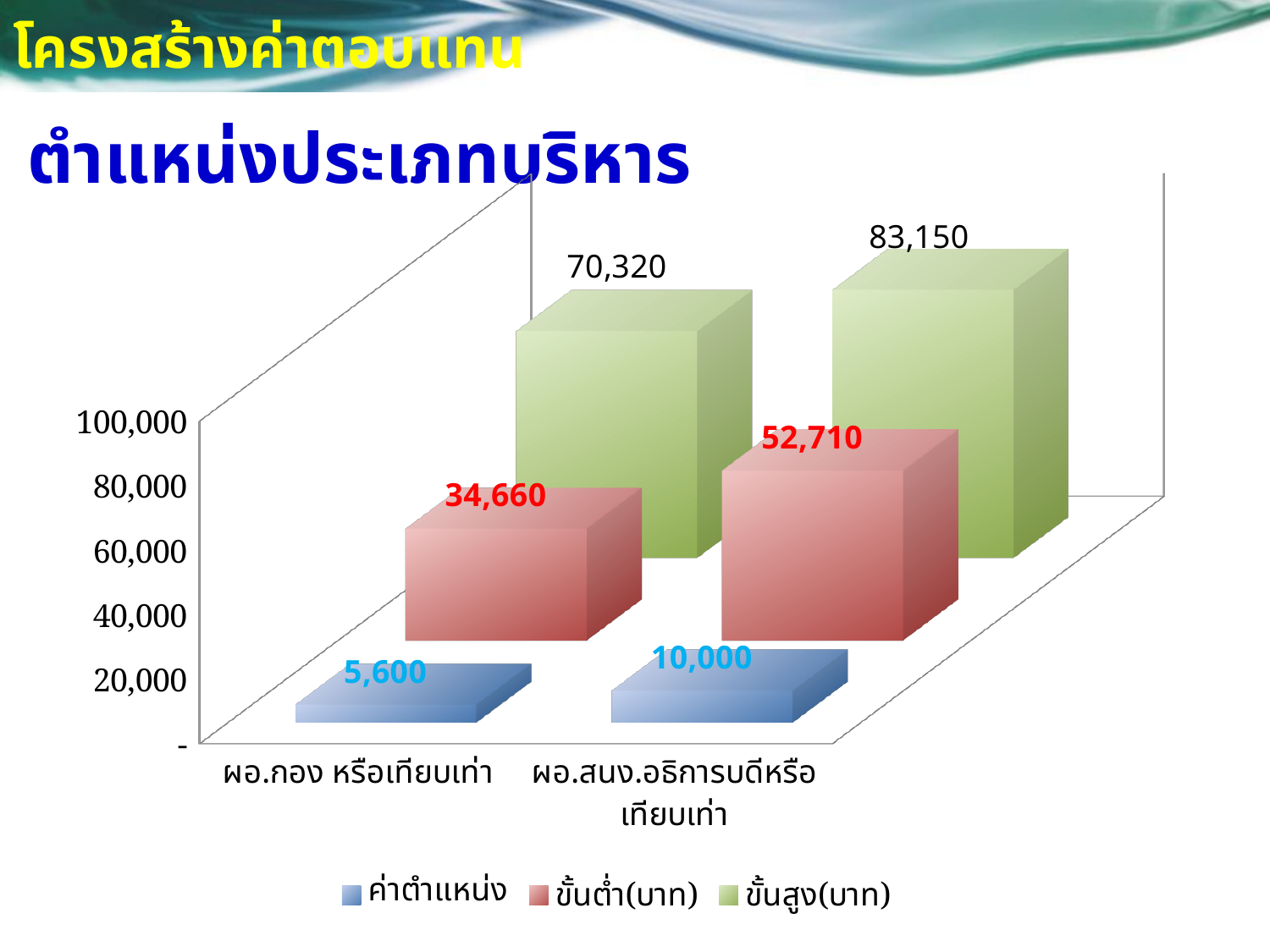
What is the ค่าตำแหน่ง value for ผอ.สนง.อธิการบดีหรือเทียบเท่า? 10,000 Which category has the highest ขั้นสูง(บาท) value? ผอ.สนง.อธิการบดีหรือเทียบเท่า What is the ขั้นต่ำ(บาท) value for ผอ.สนง.อธิการบดีหรือเทียบเท่า? 52,710 What is the difference between the ขั้นต่ำ(บาท) values of ผอ.สนง.อธิการบดีหรือเทียบเท่า and ผอ.กอง หรือเทียบเท่า? 18,050 Which is larger: the ขั้นสูง(บาท) value for ผอ.กอง หรือเทียบเท่า or the ขั้นต่ำ(บาท) value for ผอ.สนง.อธิการบดีหรือเทียบเท่า? ขั้นสูง(บาท) for ผอ.กอง หรือเทียบเท่า How many categories are shown on the x axis? 2 What kind of chart is shown on the slide? Bar chart What is the ค่าตำแหน่ง value for ผอ.กอง หรือเทียบเท่า? 5,600 Which colour represents the ขั้นสูง(บาท) series in the legend? Green What is the ขั้นสูง(บาท) value for ผอ.กอง หรือเทียบเท่า? 70,320 How many series does the legend list? 3 Which series has the lowest value for ผอ.กอง หรือเทียบเท่า? ค่าตำแหน่ง